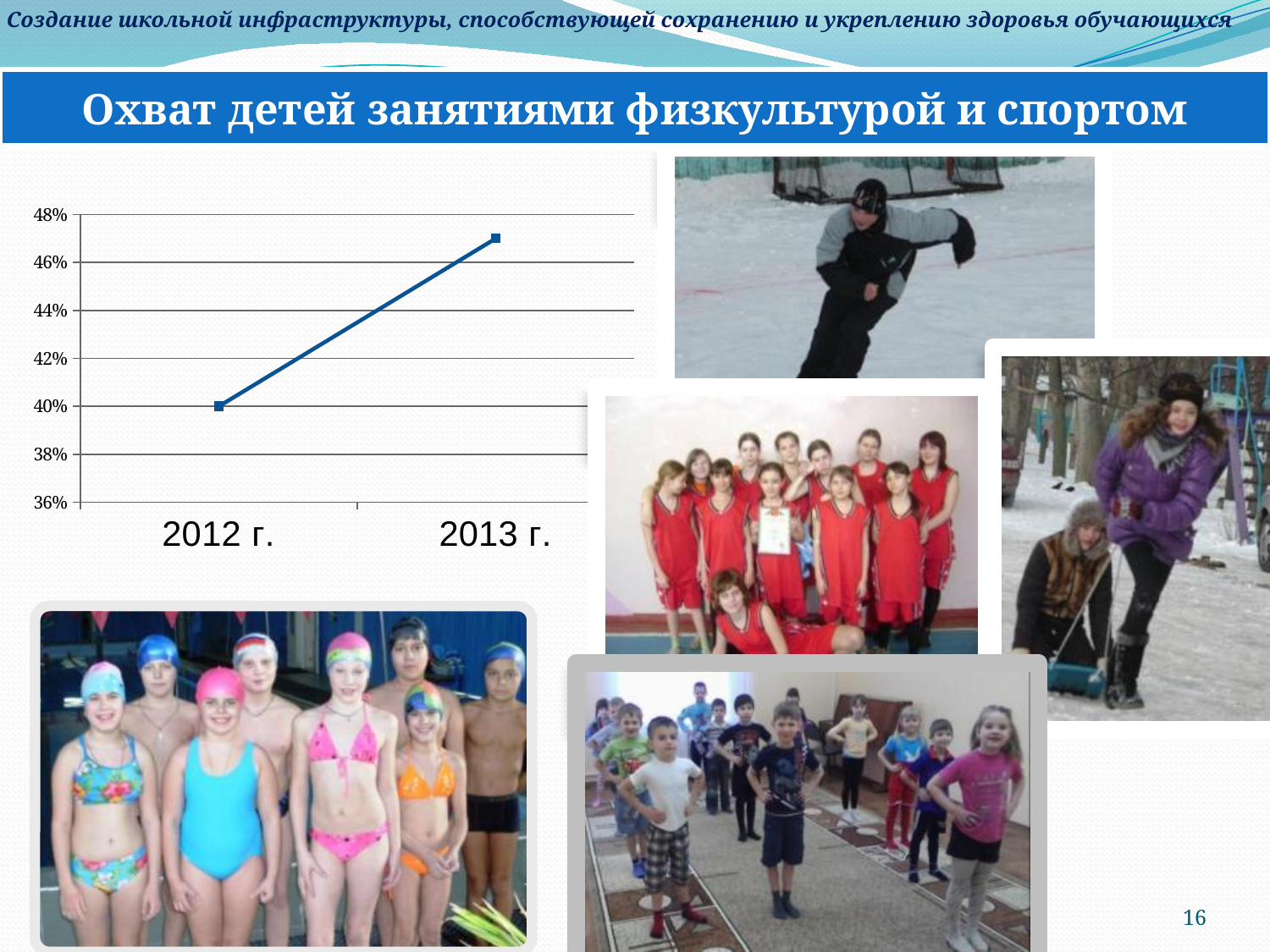
What is the title above the chart? Охват детей занятиями физкультурой и спортом Which year has the higher value, 2012 г. or 2013 г.? 2013 г. Which year has the highest value on the chart? 2013 г. Is the value for 2013 г. greater or less than 46%? greater What is the value for 2012 г.? 40% Is the value for 2013 г. greater or less than 48%? less Do the values rise or fall from 2012 г. to 2013 г.? rise How many points are plotted on the chart? 2 Is the value for 2012 г. greater or less than 42%? less Which year has the lowest value on the chart? 2012 г. What kind of chart is shown on the slide? line chart What is the lowest value shown on the vertical axis of the chart? 36%